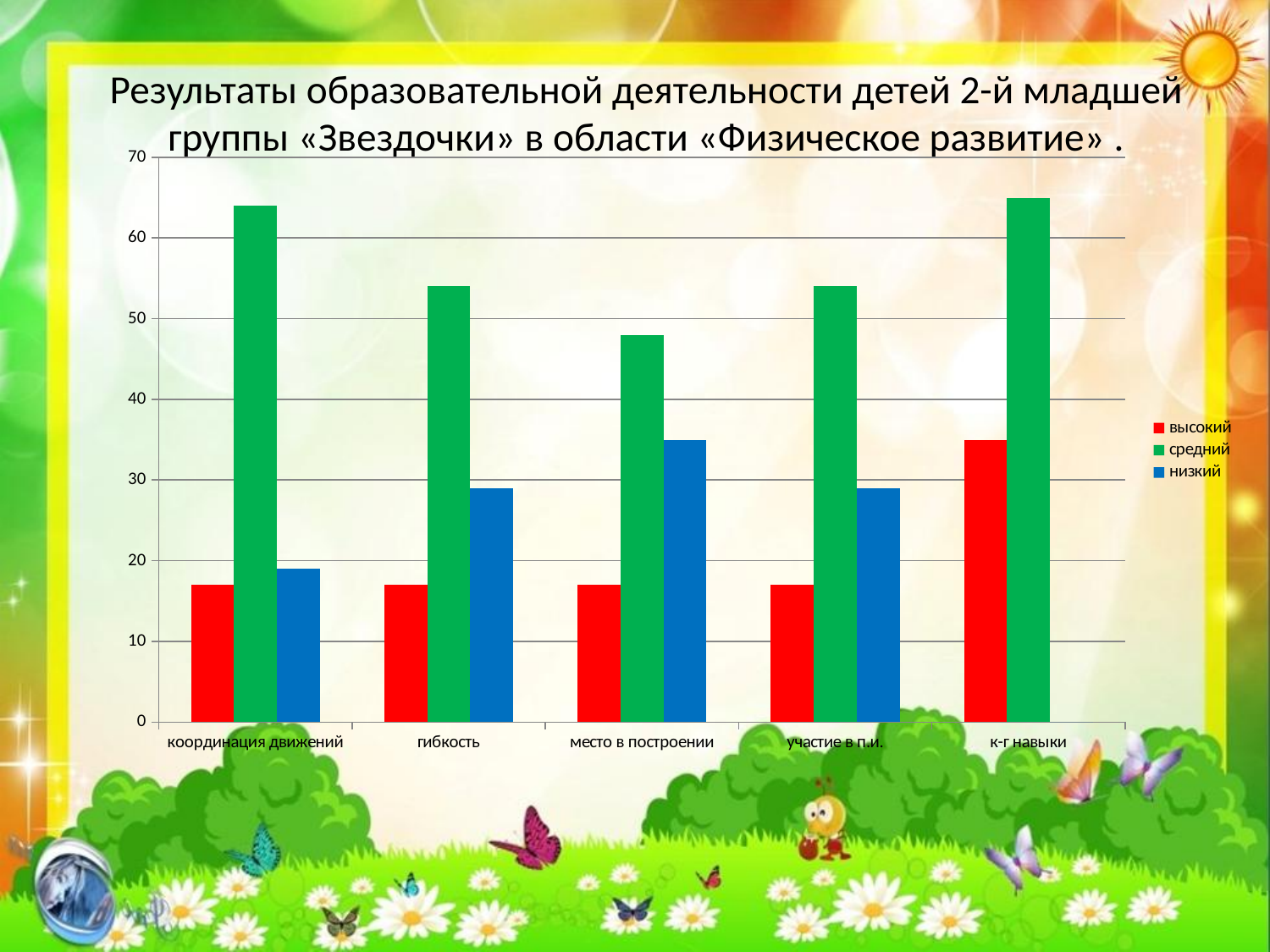
Is the value of "высокий" for "к-г навыки" greater or less than 30? greater How many categories are shown along the x axis of the chart? 5 Which category has the highest value for the series "высокий"? к-г навыки Is the value of "высокий" for "гибкость" greater or less than 20? less Is the value of "средний" for "координация движений" greater or less than 60? greater Which category has the lowest value for the series "средний"? место в построении For "гибкость", which is larger: the value of "средний" or the value of "низкий"? средний Which colour represents the series "средний" in the chart's legend? green Which category has the highest value for the series "низкий"? место в построении What kind of chart is shown on the slide? bar chart How many series does the chart's legend list? 3